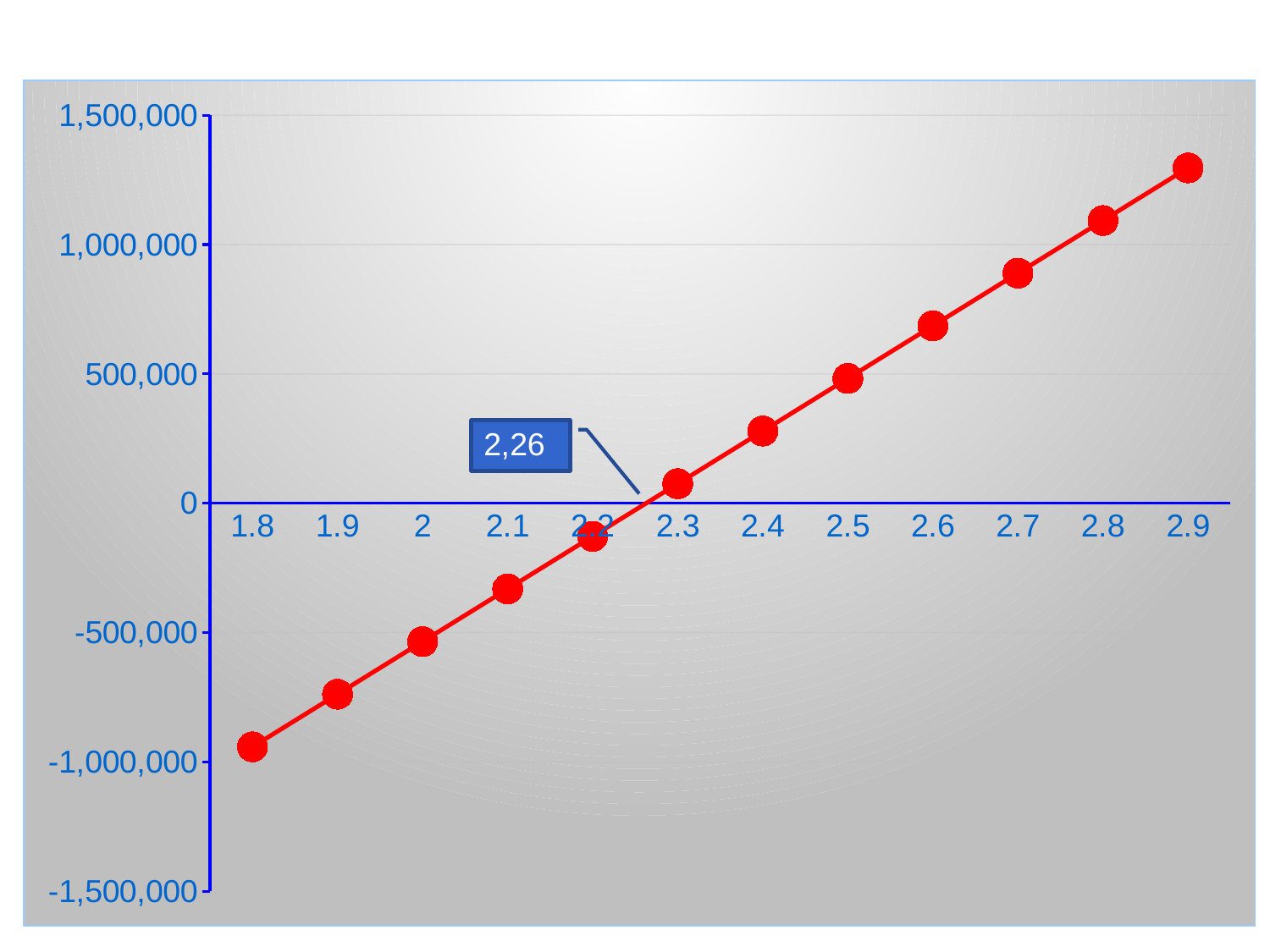
Is the value at x = 1.8 greater or less than -500,000? less What text is shown in the callout box pointing to where the line crosses the x-axis? 2,26 Is the value at x = 2.6 greater or less than 500,000? greater Do the plotted values rise or fall as the x-axis goes from 1.8 to 2.9? rise Is the value at x = 2.9 greater or less than 1,000,000? greater What kind of chart is shown on the slide? line chart How many data points are plotted on the line? 12 At which x value is the plotted value lowest? 1.8 At which x value is the plotted value highest? 2.9 Which is larger, the value at x = 2.7 or the value at x = 2.1? 2.7